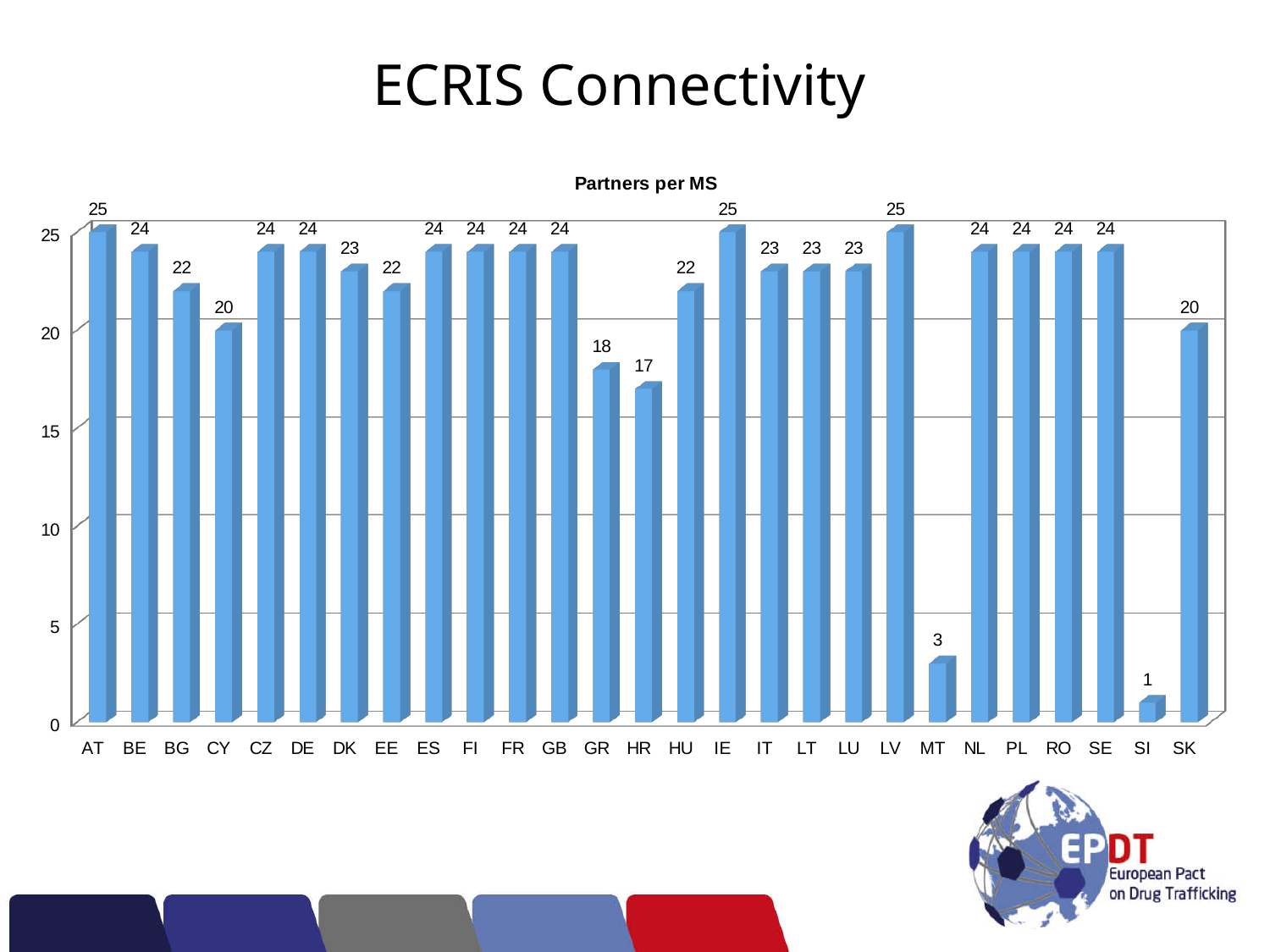
What is the value for HR? 17 Which member state has the lowest number of partners? SI Which has a larger value, MT or SK? SK What is the value for MT in the Partners per MS chart? 3 Is the value for HR greater or less than 20? less What kind of chart is shown on the slide? bar chart What is the value for CY? 20 What is the value for GR? 18 How many member states are shown on the x axis? 27 What is the title of the chart? Partners per MS What is the difference between the values for GR and HR? 1 What is the difference between the values for AT and SI? 24